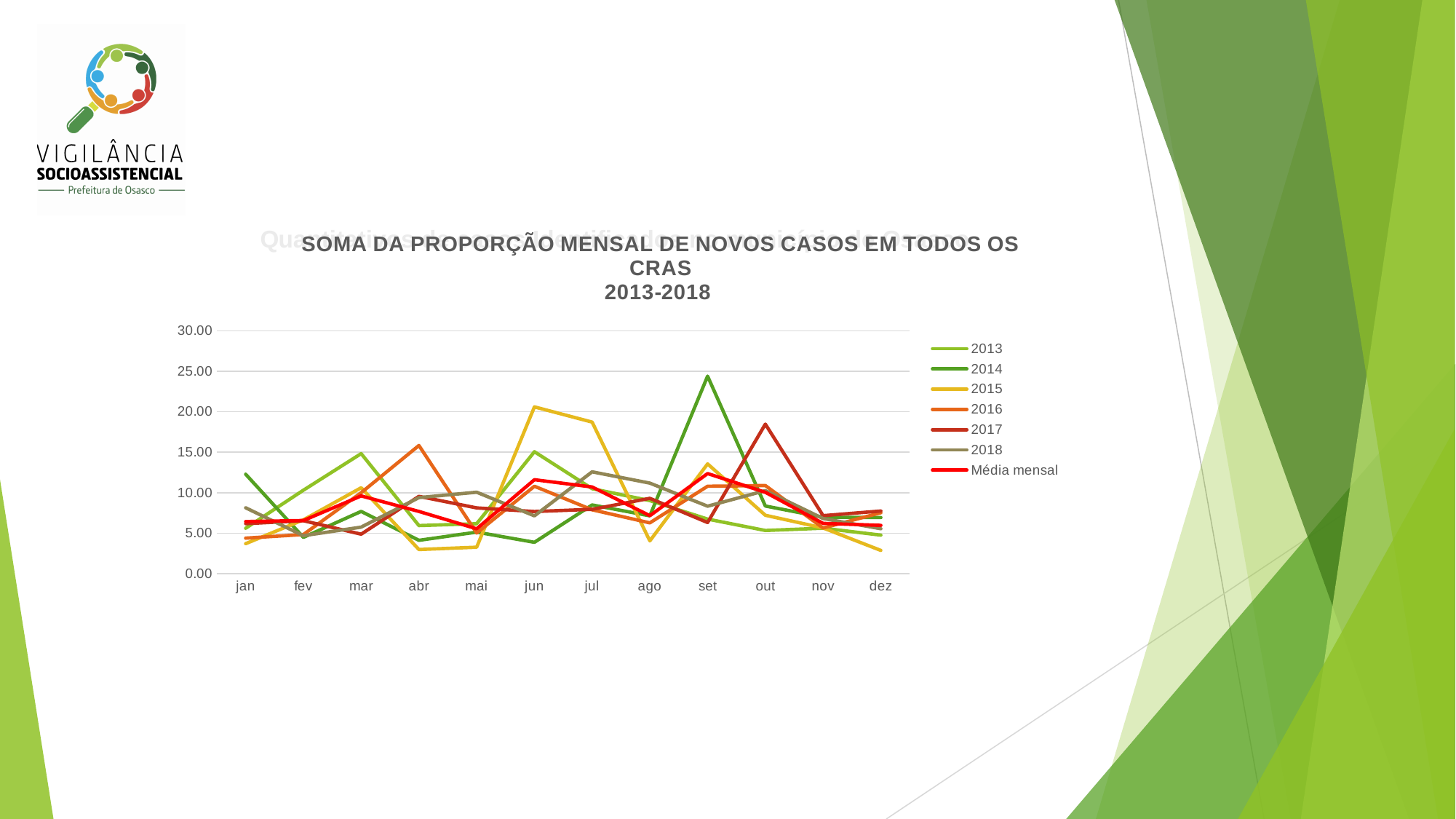
Is the value for 2016 in abr greater or less than 15.00? greater Is the value for 2015 in dez greater or less than 5.00? less What is the last entry listed in the legend? Média mensal In which month does the 2017 series reach its highest value? out Which is larger: the value for 2014 in set or the value for 2017 in out? 2014 in set In which month does the 2014 series reach its highest value? set What kind of chart is shown on the slide? line chart Is the value for 2014 in set greater or less than 20.00? greater In which month does the 2015 series reach its highest value? jun How many months are shown along the x axis? 12 How many series does the legend list? 7